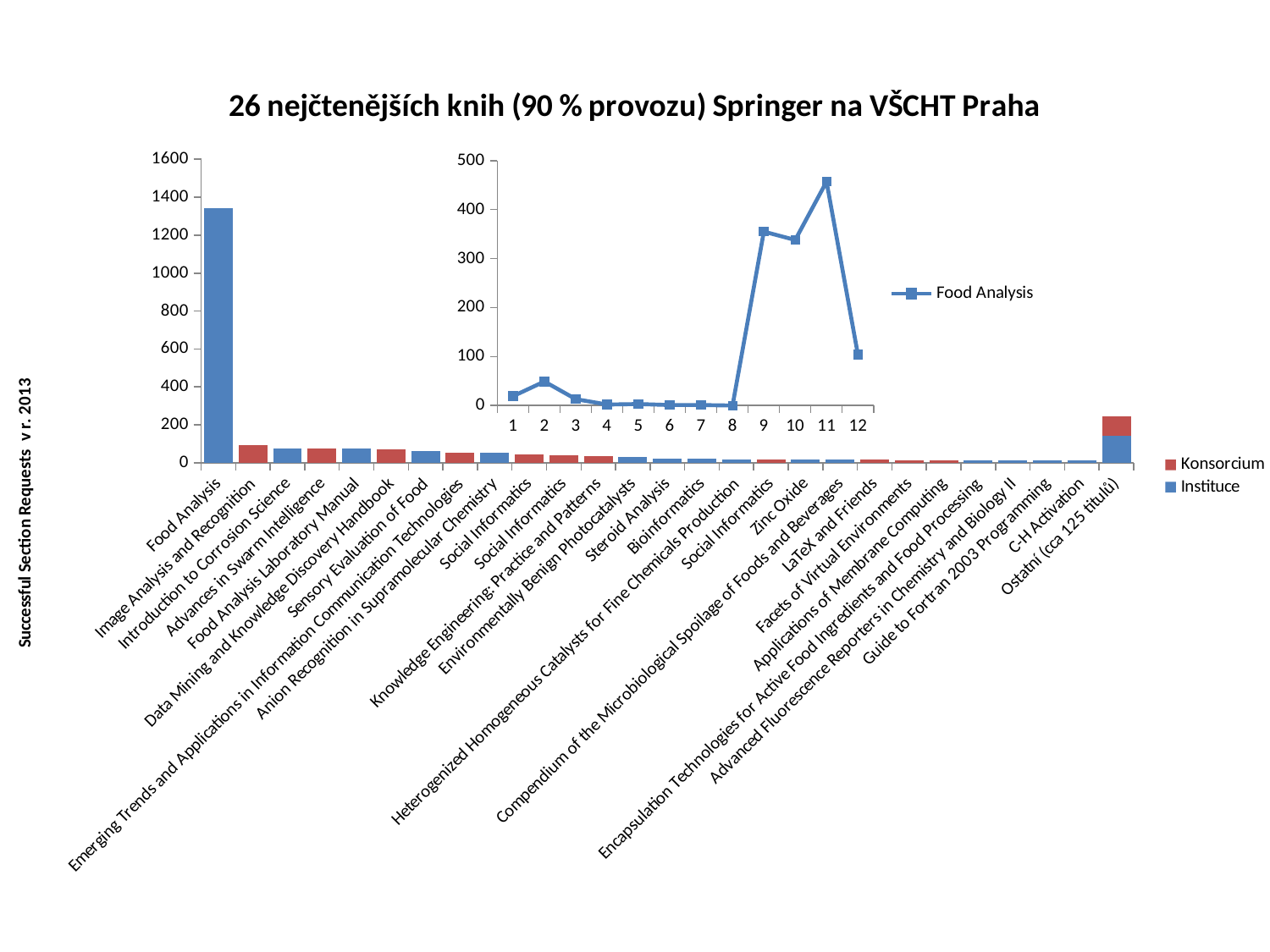
How many categories are shown on the x axis of the bar chart? 27 In the inset Food Analysis line chart, at which x value is the highest point? 11 In the bar chart, is the value for Food Analysis greater or less than 1400? less How many series does the legend of the bar chart list? 2 In the inset Food Analysis line chart, is the value at x = 11 greater or less than 400? greater In the bar chart, is the value for Food Analysis greater or less than 1200? greater In the bar chart, which is larger: the bar for Ostatní (cca 125 titulů) or the bar for Image Analysis and Recognition? Ostatní (cca 125 titulů) What is the title of the slide's main chart? 26 nejčtenějších knih (90 % provozu) Springer na VŠCHT Praha What kind of chart is the large chart with the book titles on the x axis? bar chart In the bar chart, which category has the highest bar? Food Analysis What kind of chart is the inset chart labelled Food Analysis? line chart